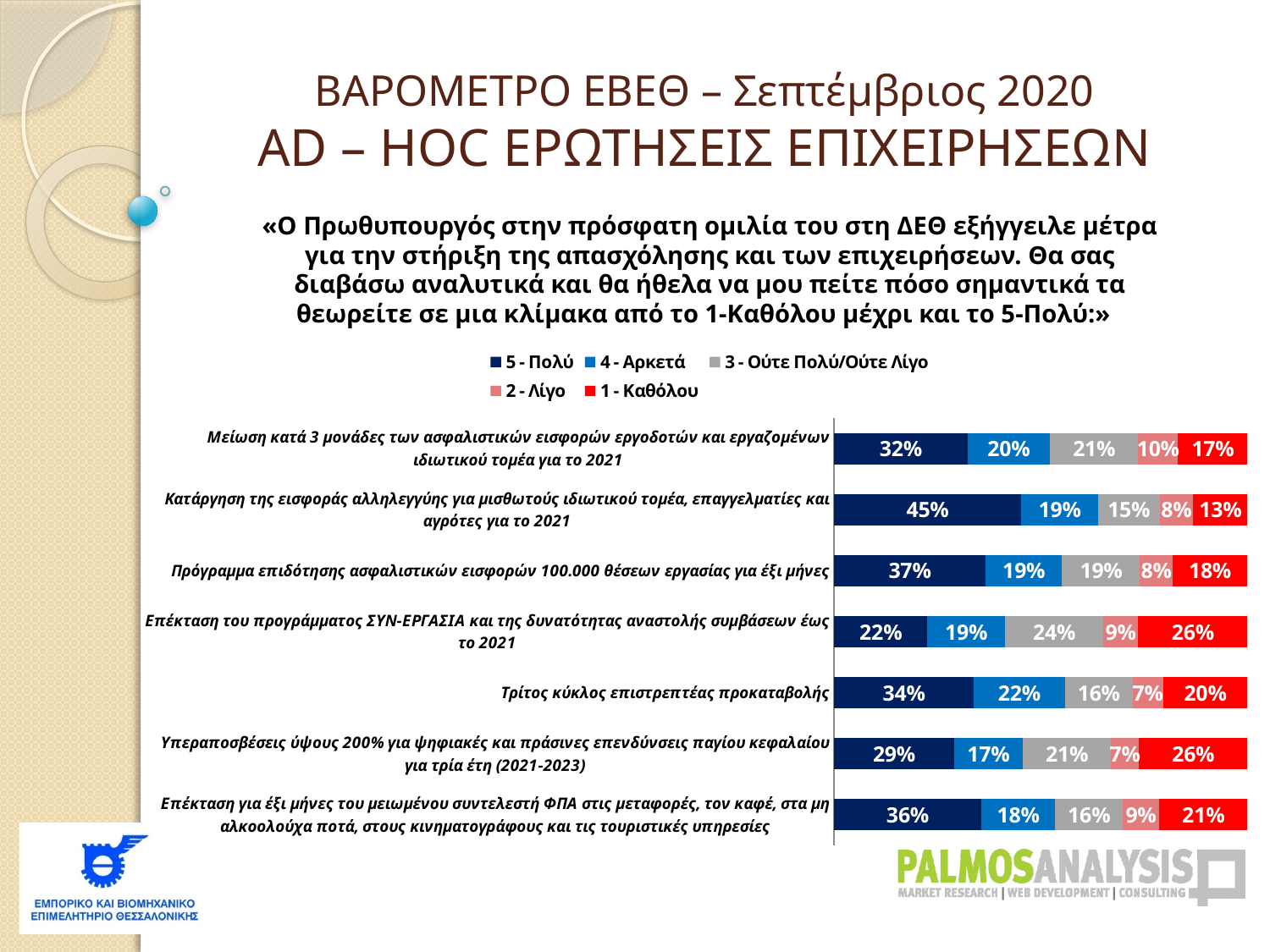
What is the '2 - Λίγο' value for 'Μείωση κατά 3 μονάδες των ασφαλιστικών εισφορών εργοδοτών και εργαζομένων ιδιωτικού τομέα για το 2021'? 10% Which measure has the lowest '5 - Πολύ' value? Επέκταση του προγράμματος ΣΥΝ-ΕΡΓΑΣΙΑ και της δυνατότητας αναστολής συμβάσεων έως το 2021 What kind of chart is shown on the slide? Stacked horizontal bar chart How many series does the legend list? 5 What is the '5 - Πολύ' value for 'Κατάργηση της εισφοράς αλληλεγγύης για μισθωτούς ιδιωτικού τομέα, επαγγελματίες και αγρότες για το 2021'? 45% Which is larger: the '4 - Αρκετά' value for 'Τρίτος κύκλος επιστρεπτέας προκαταβολής' or for 'Επέκταση για έξι μήνες του μειωμένου συντελεστή ΦΠΑ στις μεταφορές, τον καφέ, στα μη αλκοολούχα ποτά, στους κινηματογράφους και τις τουριστικές υπηρεσίες'? Τρίτος κύκλος επιστρεπτέας προκαταβολής What is the '1 - Καθόλου' value for 'Επέκταση του προγράμματος ΣΥΝ-ΕΡΓΑΣΙΑ και της δυνατότητας αναστολής συμβάσεων έως το 2021'? 26% What is the '3 - Ούτε Πολύ/Ούτε Λίγο' value for 'Τρίτος κύκλος επιστρεπτέας προκαταβολής'? 16% What is the difference between the '5 - Πολύ' values for 'Πρόγραμμα επιδότησης ασφαλιστικών εισφορών 100.000 θέσεων εργασίας για έξι μήνες' and 'Υπεραποσβέσεις ύψους 200% για ψηφιακές και πράσινες επενδύσεις παγίου κεφαλαίου για τρία έτη (2021-2023)'? 8% Which measure has the highest '5 - Πολύ' value? Κατάργηση της εισφοράς αλληλεγγύης για μισθωτούς ιδιωτικού τομέα, επαγγελματίες και αγρότες για το 2021 How many categories (measures) are plotted in the chart? 7 What is the total of all segments in the bar for 'Τρίτος κύκλος επιστρεπτέας προκαταβολής'? 99%